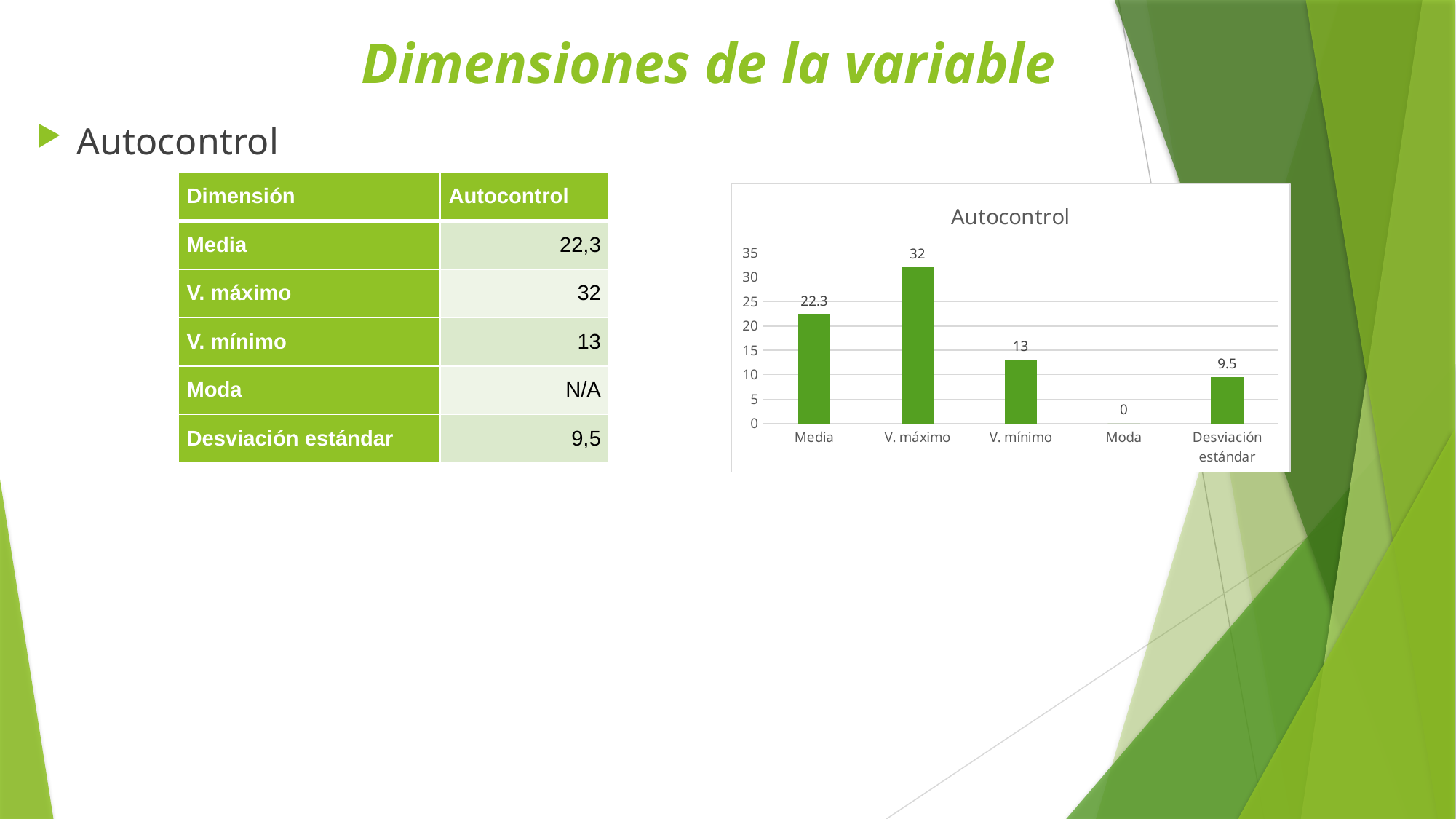
Which category has the lowest value in the Autocontrol chart? Moda What is the value for Desviación estándar in the Autocontrol chart? 9.5 What is the value shown for Moda in the Autocontrol chart? 0 What is the difference between V. máximo and V. mínimo in the Autocontrol chart? 19 What is the title of the chart on the slide? Autocontrol What is the value for V. máximo in the Autocontrol chart? 32 Is the value for Desviación estándar in the Autocontrol chart greater or less than 10? less Which is larger in the Autocontrol chart, Media or V. mínimo? Media How many categories are shown on the x axis of the Autocontrol chart? 5 What is the value for Media in the Autocontrol chart? 22.3 Which category has the highest value in the Autocontrol chart? V. máximo What kind of chart is the Autocontrol chart? bar chart